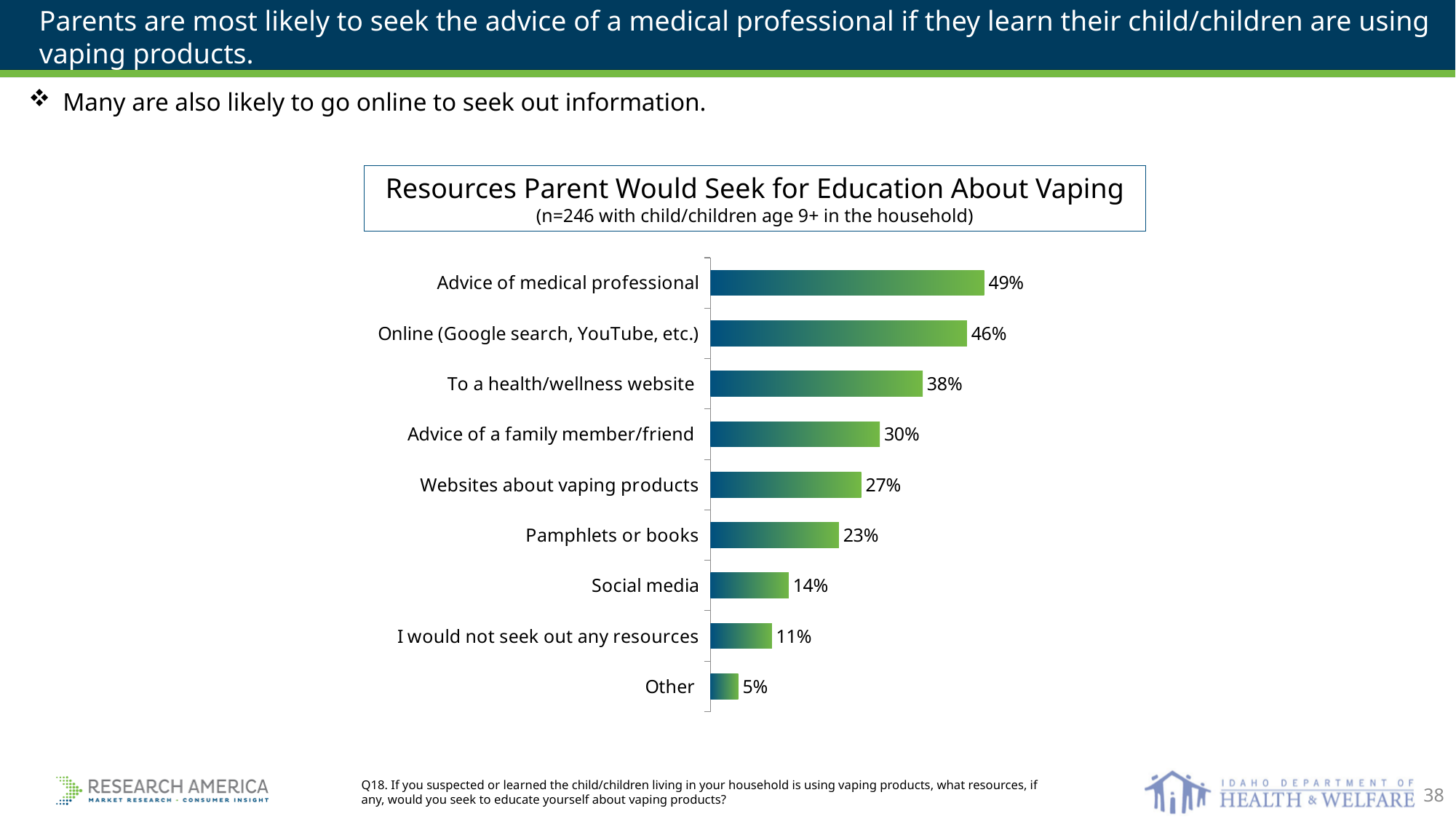
Which is larger: the percentage for 'Websites about vaping products' or for 'Social media'? Websites about vaping products Which category has the lowest percentage in the chart? Other What is the difference in percentage points between 'Advice of medical professional' and 'Online (Google search, YouTube, etc.)'? 3 percentage points What percentage of parents would go to a health/wellness website? 38% What percentage of parents would seek the advice of a medical professional? 49% Which resource has the highest percentage in the chart? Advice of medical professional How many resource categories are shown in the chart? 9 What is the title of the chart? Resources Parent Would Seek for Education About Vaping What is the difference in percentage points between 'Advice of a family member/friend' and 'Pamphlets or books'? 7 percentage points What percentage of parents would use social media as a resource? 14% What is the sample size (n) stated in the chart subtitle? 246 What type of chart is used on this slide? Bar chart